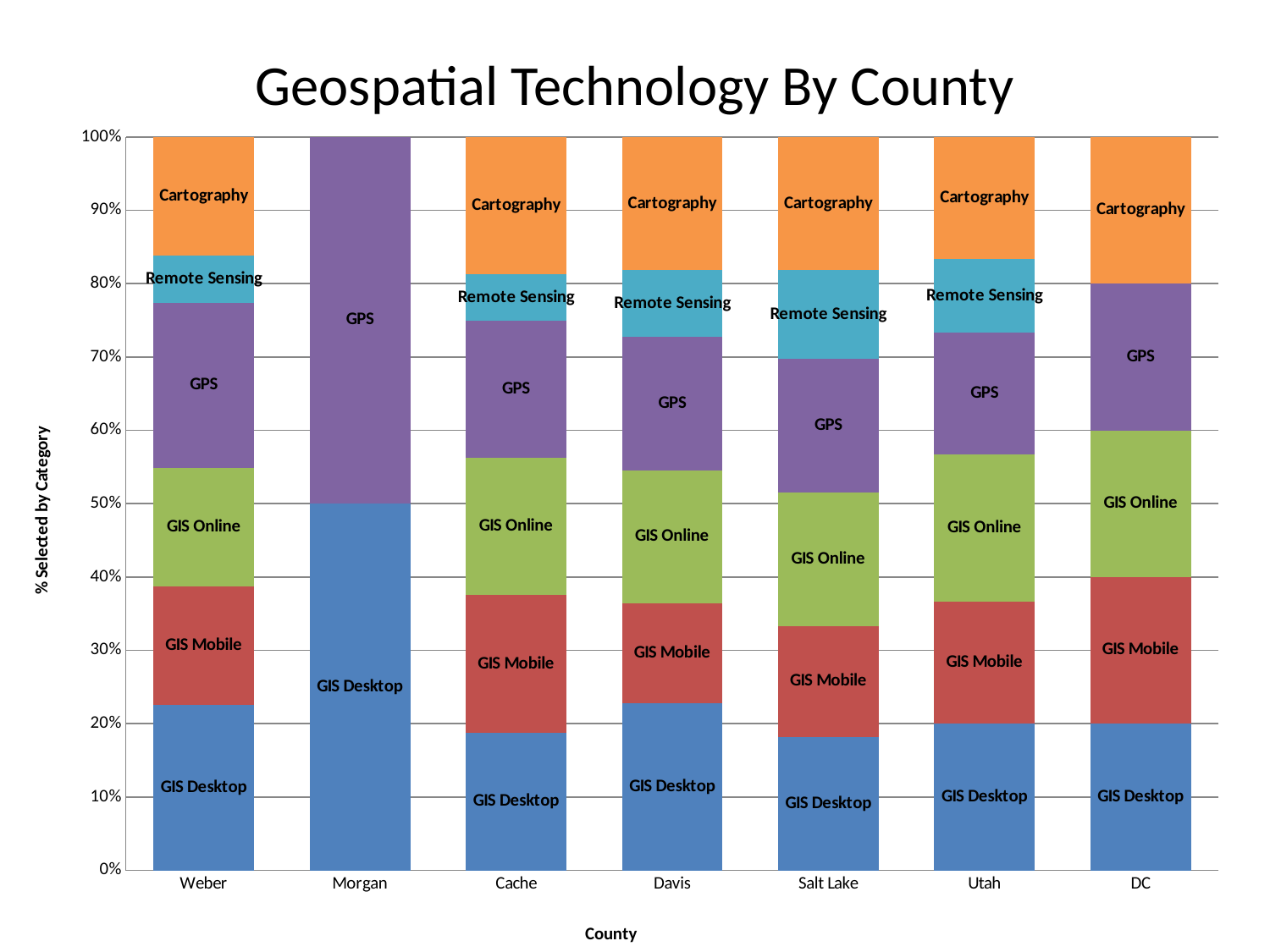
Which county has the largest GIS Desktop segment? Morgan What is the title of the chart? Geospatial Technology By County What is the GIS Desktop share for DC? 20% What is the GIS Desktop share for Morgan? 50% What is the GPS share for Morgan? 50% What is the total of the Weber stacked bar? 100% What kind of chart is shown on the slide? Stacked bar chart Is the GIS Desktop value for Weber greater or less than 20%? greater How many counties are shown along the x axis? 7 How many categories make up the Morgan bar? 2 Which is larger, the Remote Sensing segment for Salt Lake or for Weber? Salt Lake Is the GIS Desktop value for Salt Lake greater or less than 20%? less